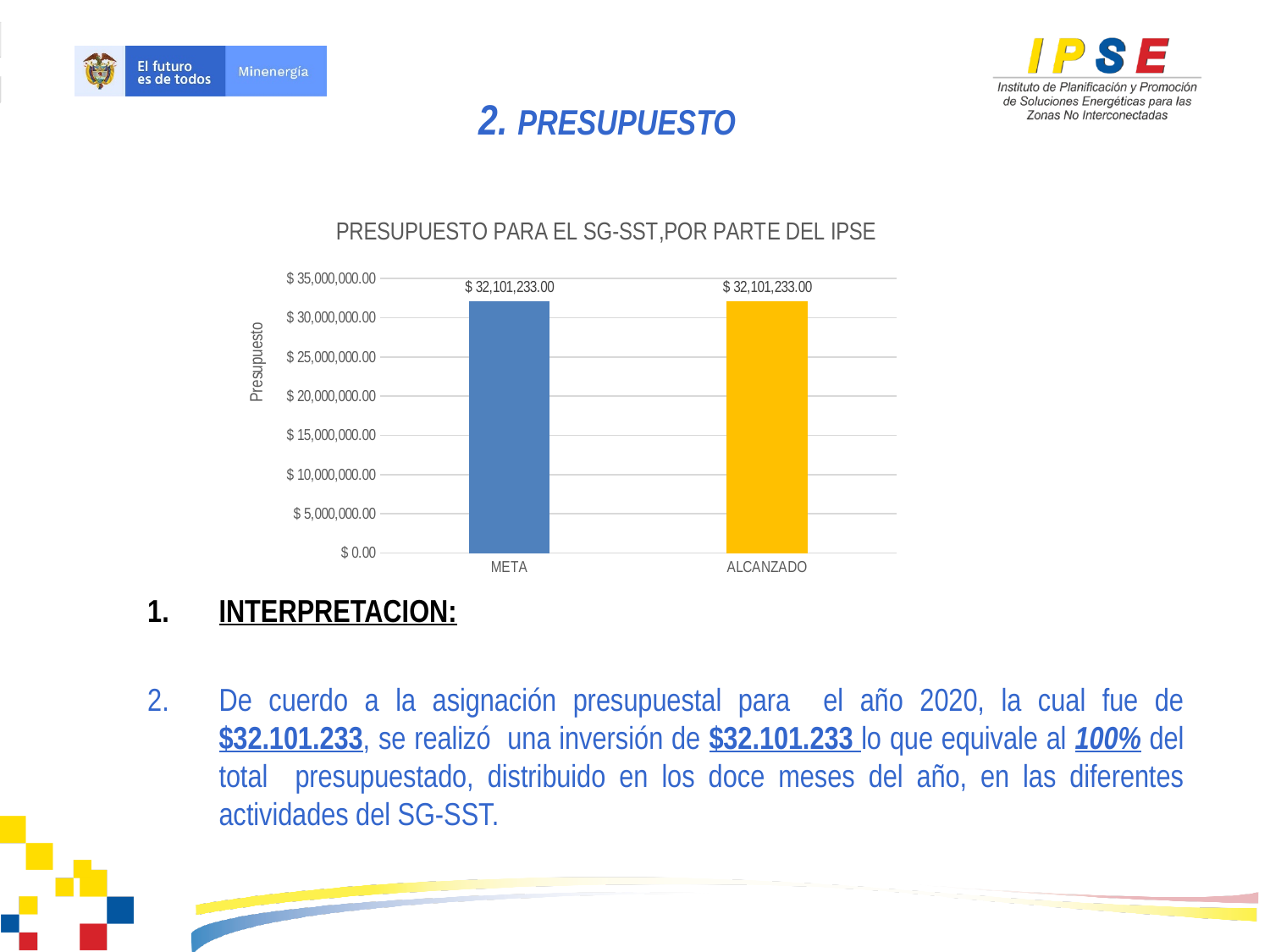
What is the difference between the META and ALCANZADO values? $ 0.00 What is the label of the y axis? Presupuesto What is the title of the chart? PRESUPUESTO PARA EL SG-SST,POR PARTE DEL IPSE What is the value for META? $ 32,101,233.00 What kind of chart is shown? bar chart Is the value for ALCANZADO greater or less than $ 35,000,000.00? less Are the values for META and ALCANZADO equal? Yes What is the value for ALCANZADO? $ 32,101,233.00 How many categories are shown on the x axis? 2 Is the value for META greater or less than $ 30,000,000.00? greater